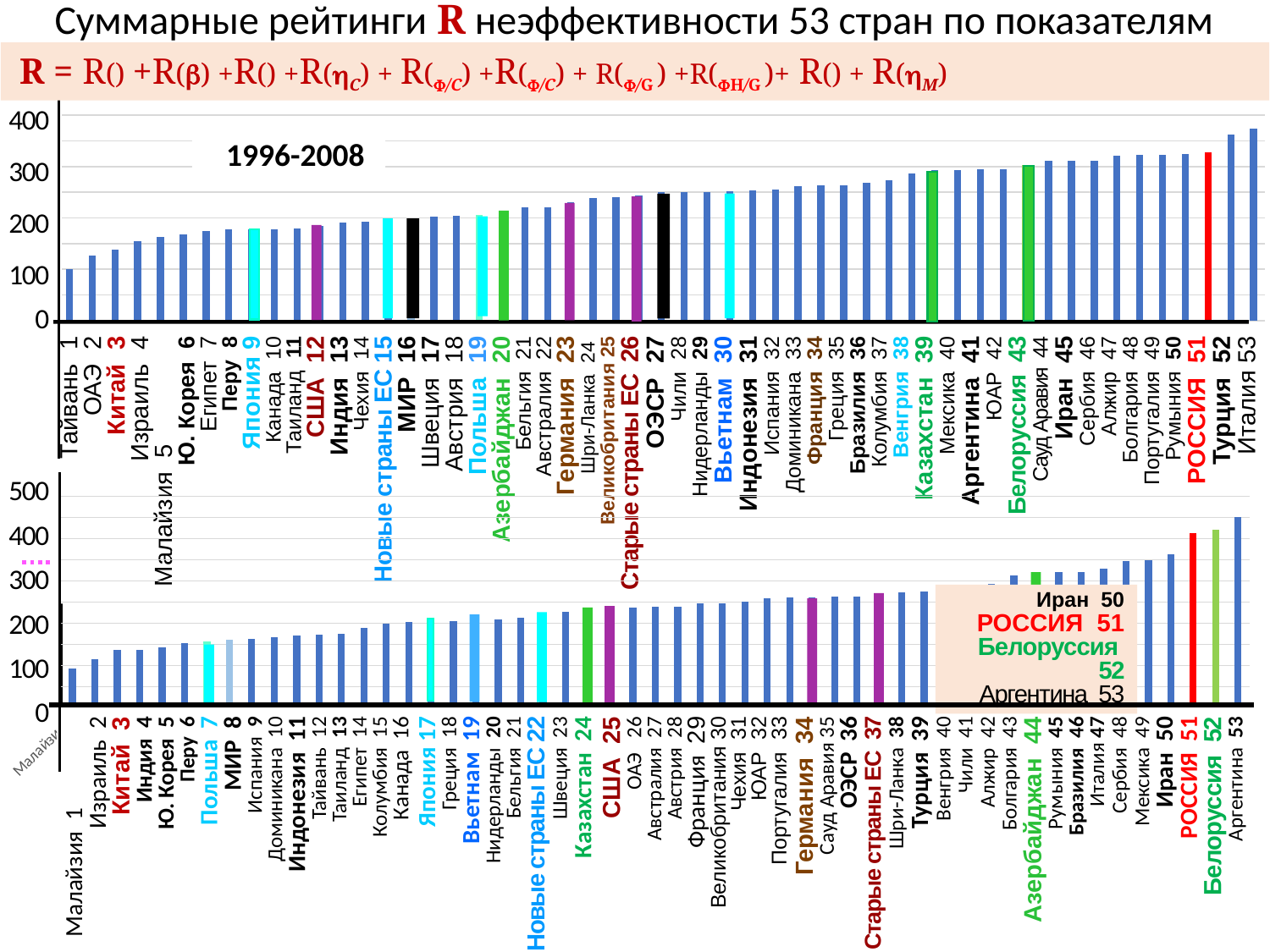
In the top chart (1996-2008), is the value for Китай greater or less than 200? less In the top chart (1996-2008), which country has the highest value? Италия In the bottom chart, is the value for Аргентина greater or less than 400? greater In the bottom chart, is the value for Иран greater or less than 400? less In the top chart (1996-2008), which has the larger value, РОССИЯ or Китай? РОССИЯ In the bottom chart, which country has the highest value? Аргентина Do the values in the bottom chart rise or fall from left to right along the x axis? rise In the top chart (1996-2008), which country has the lowest value? Тайвань What kind of chart is the top chart on the slide? bar chart What rank number is shown for США in the top chart (1996-2008)? 12 In the bottom chart, which country has the lowest value? Малайзия